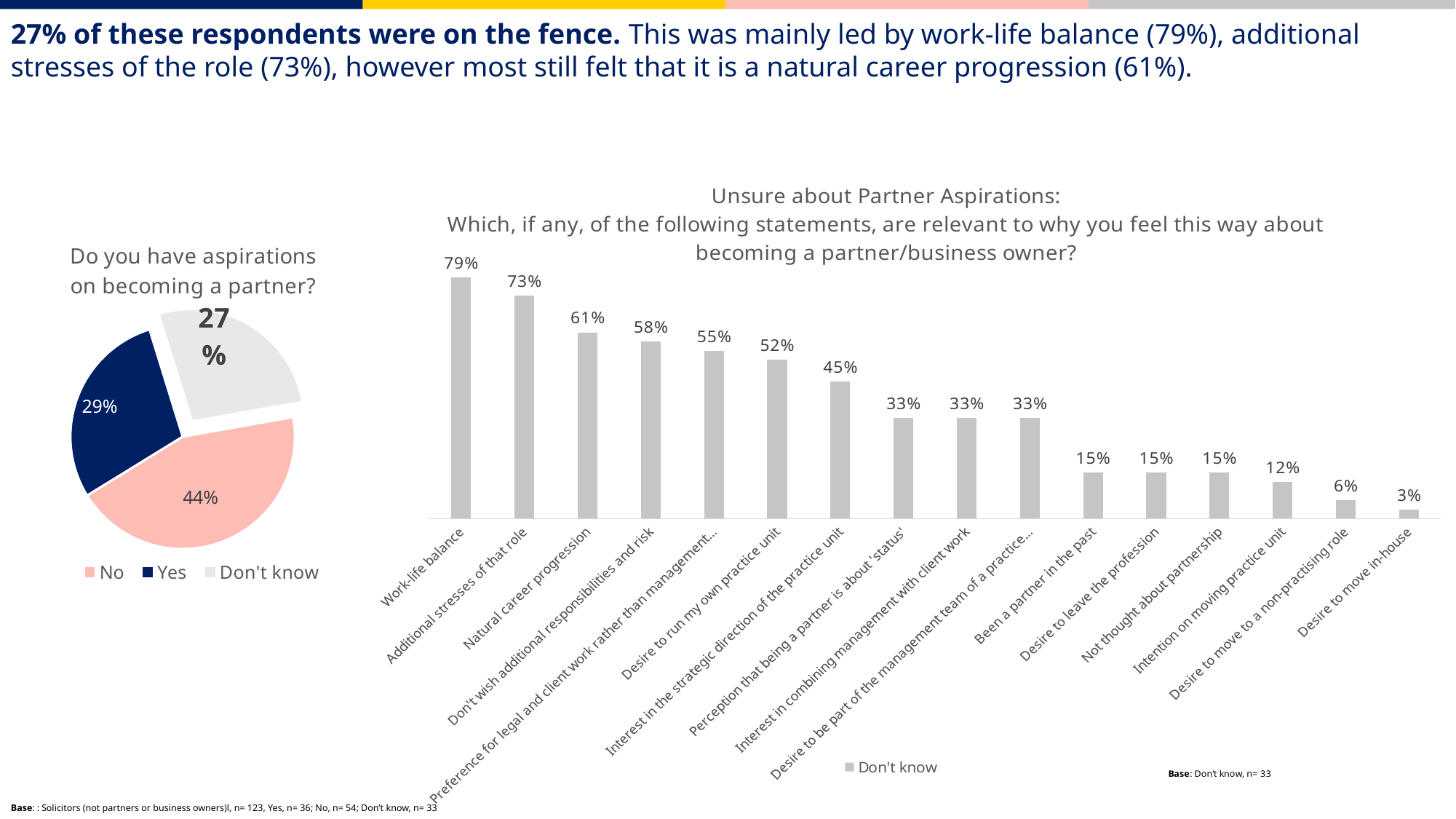
In the pie chart 'Do you have aspirations on becoming a partner?', what share of respondents answered 'No'? 44% In the bar chart 'Unsure about Partner Aspirations', which is larger: 'Interest in the strategic direction of the practice unit' or 'Been a partner in the past'? Interest in the strategic direction of the practice unit In the bar chart 'Unsure about Partner Aspirations', what is the difference between 'Work-life balance' and 'Additional stresses of that role'? 6% What type of chart is the 'Unsure about Partner Aspirations' chart? Bar chart In the pie chart 'Do you have aspirations on becoming a partner?', what share of respondents answered 'Don't know'? 27% In the bar chart 'Unsure about Partner Aspirations', which statement has the highest value? Work-life balance In the pie chart 'Do you have aspirations on becoming a partner?', which response has the smallest slice? Don't know In the bar chart 'Unsure about Partner Aspirations', which statement has the lowest value? Desire to move in-house In the bar chart 'Unsure about Partner Aspirations', how many statements are plotted? 16 In the pie chart 'Do you have aspirations on becoming a partner?', how many entries does the legend list? 3 In the bar chart 'Unsure about Partner Aspirations', what is the value for 'Desire to run my own practice unit'? 52% In the bar chart 'Unsure about Partner Aspirations', what is the value for 'Natural career progression'? 61%